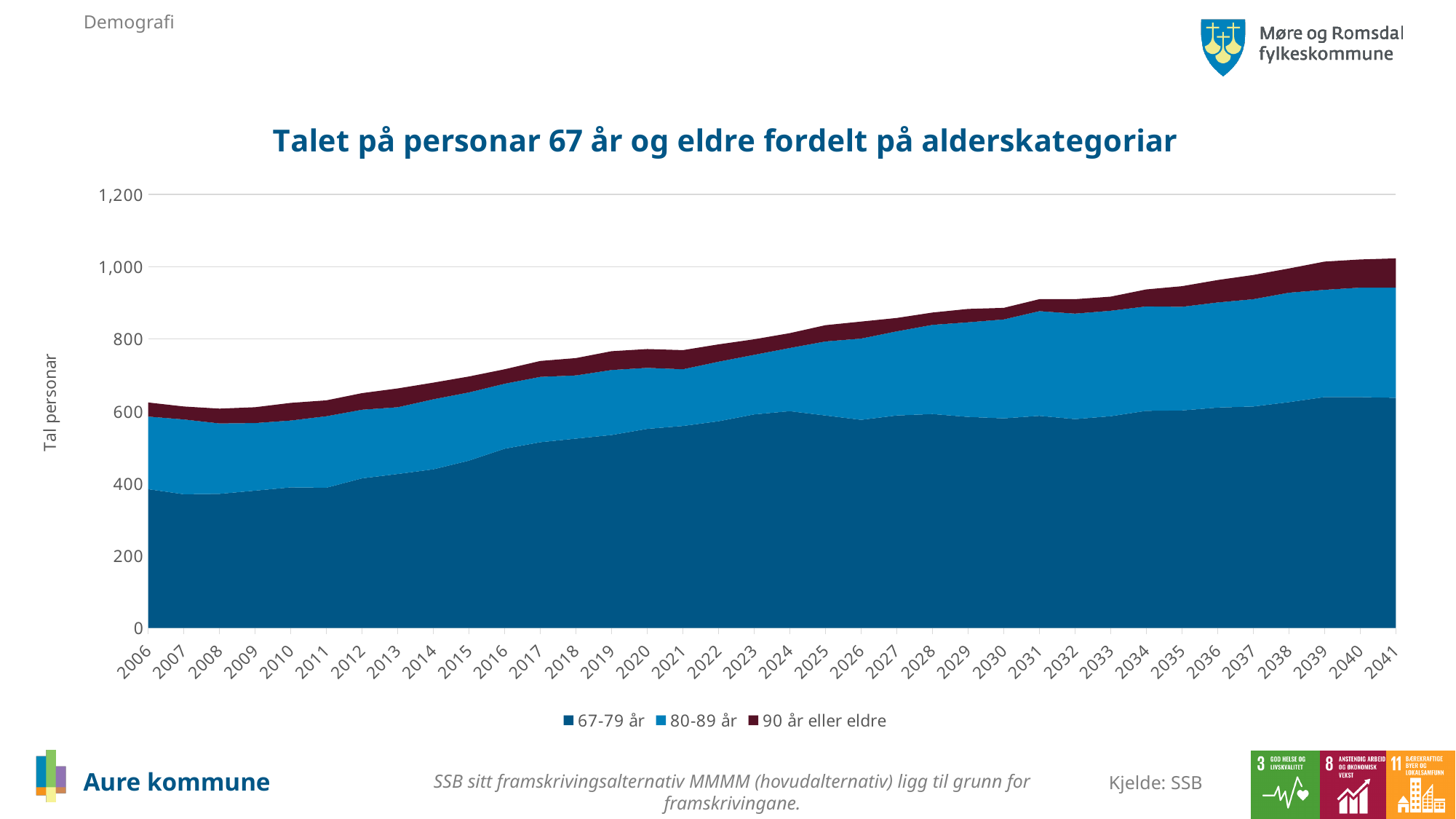
How many series does the legend list? 3 Is the value for the 67-79 år series in 2006 greater or less than 400? less Does the total number of persons 67 years and older rise or fall from 2006 to 2041? Rise Is the total for all age categories in 2041 greater or less than 1,000? greater Which series is larger in 2041, 67-79 år or 90 år eller eldre? 67-79 år What is the label on the vertical axis? Tal personar What is the title of the chart? Talet på personar 67 år og eldre fordelt på alderskategoriar What kind of chart is shown on the slide? Stacked area chart How many years are shown along the x axis? 36 Is the total for all age categories in 2021 greater or less than 800? less